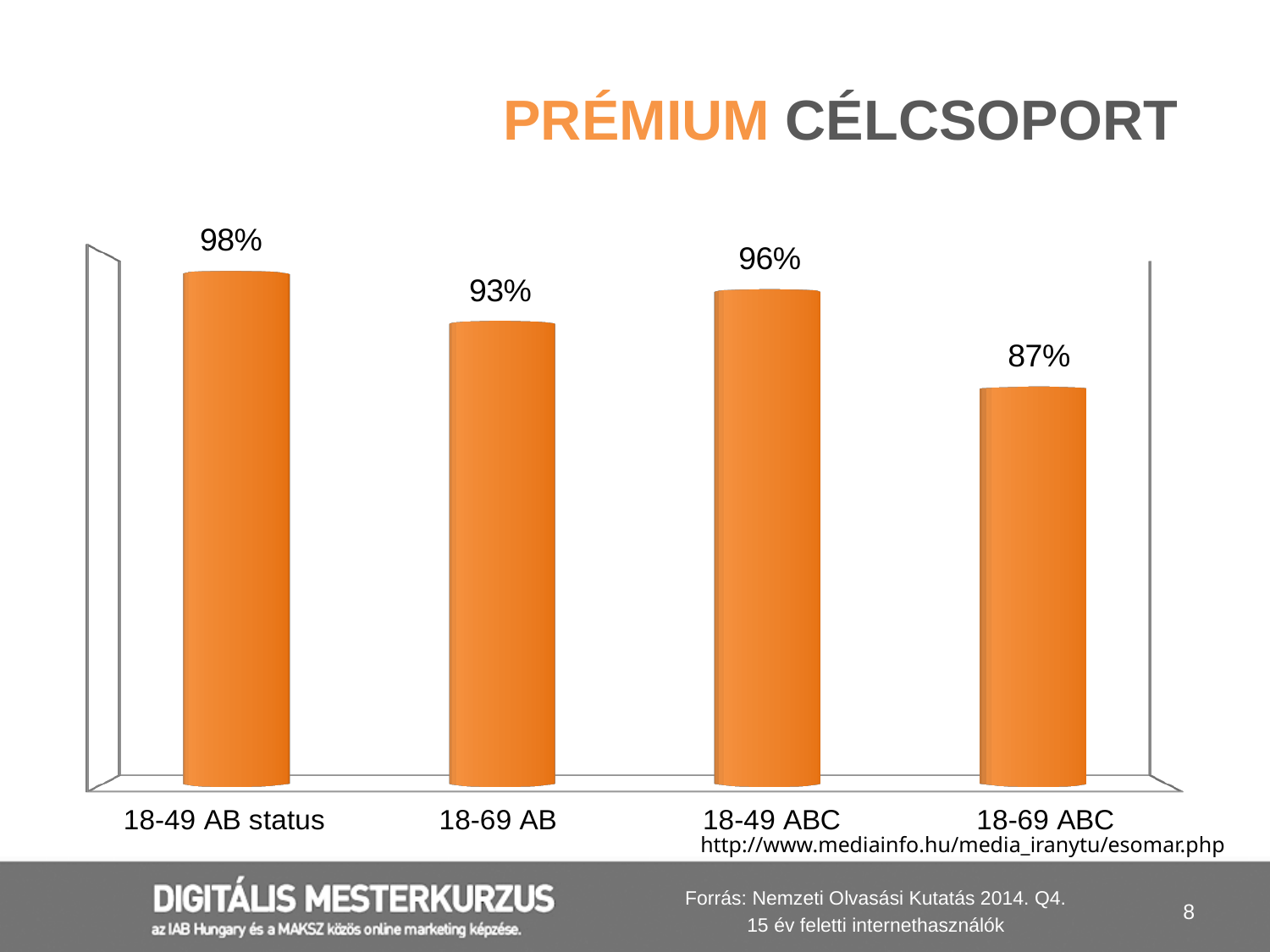
How many categories are shown in the chart? 4 What is the value for 18-49 ABC? 96% What is the value for 18-69 AB? 93% What is the value for 18-69 ABC? 87% Which category has the highest value? 18-49 AB status Which category has the lowest value? 18-69 ABC What kind of chart is shown on the slide? Bar chart Which is larger, the value for 18-69 AB or the value for 18-49 ABC? 18-49 ABC What is the difference between the values for 18-49 AB status and 18-69 ABC? 11% What is the difference between the values for 18-49 ABC and 18-69 AB? 3% What is the title of the slide? PRÉMIUM CÉLCSOPORT What is the value for 18-49 AB status? 98%